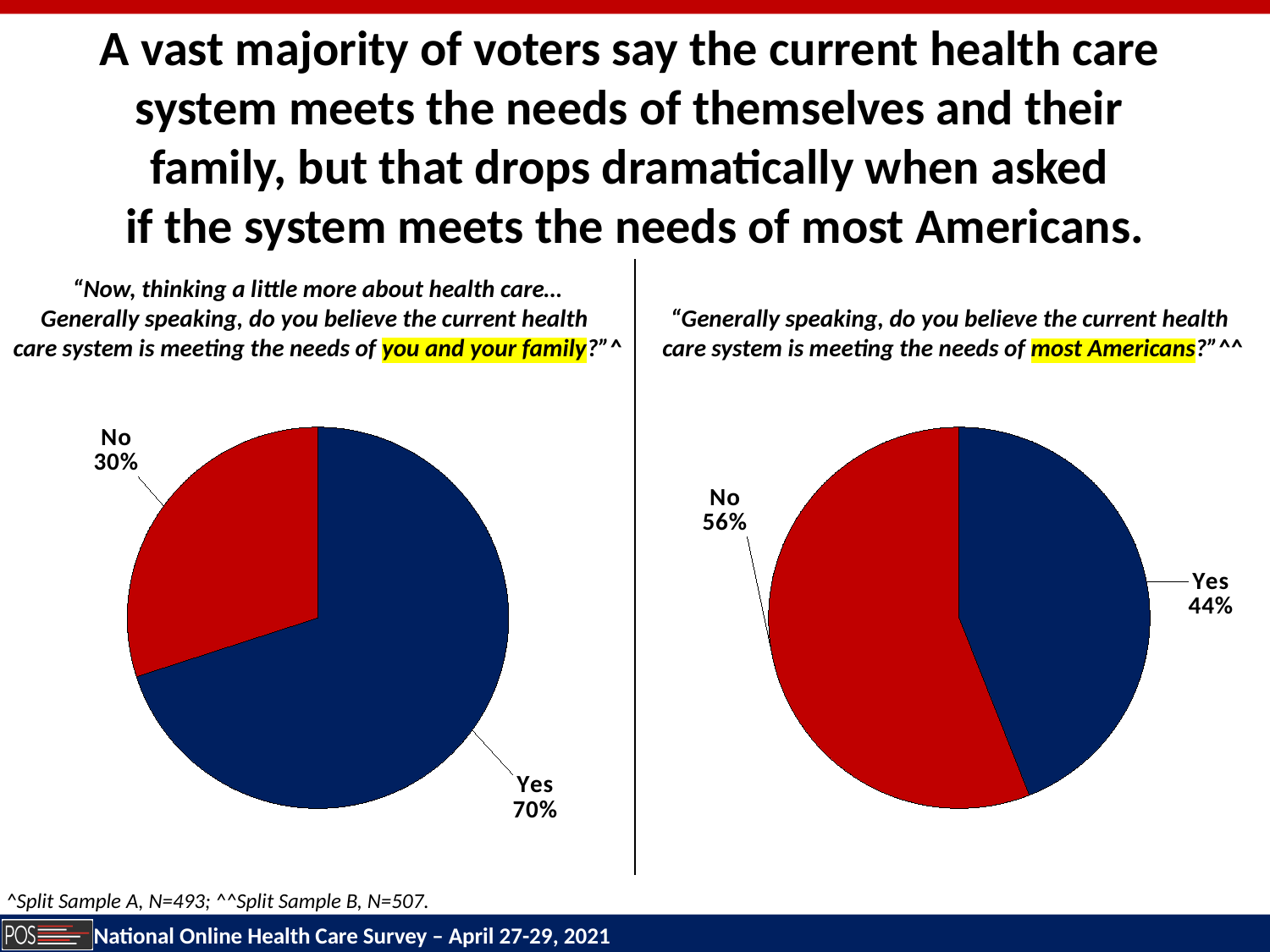
In the right pie chart (needs of most Americans), which response has the larger share? No In the left pie chart (needs of you and your family), what percentage answered No? 30% In the right pie chart (needs of most Americans), what is the difference between the No and Yes percentages? 12% In the right pie chart (needs of most Americans), what percentage answered No? 56% In the left pie chart (needs of you and your family), which response has the larger share? Yes Is the Yes share larger in the left pie chart (you and your family) or the right pie chart (most Americans)? Left (you and your family) How many slices does the right pie chart (needs of most Americans) have? 2 In the left pie chart (needs of you and your family), what colour is the Yes slice? Dark blue In the right pie chart (needs of most Americans), what percentage answered Yes? 44% What type of chart is used on the left side of the slide? Pie chart In the left pie chart (needs of you and your family), what is the difference between the Yes and No percentages? 40% In the left pie chart (needs of you and your family), what percentage answered Yes? 70%